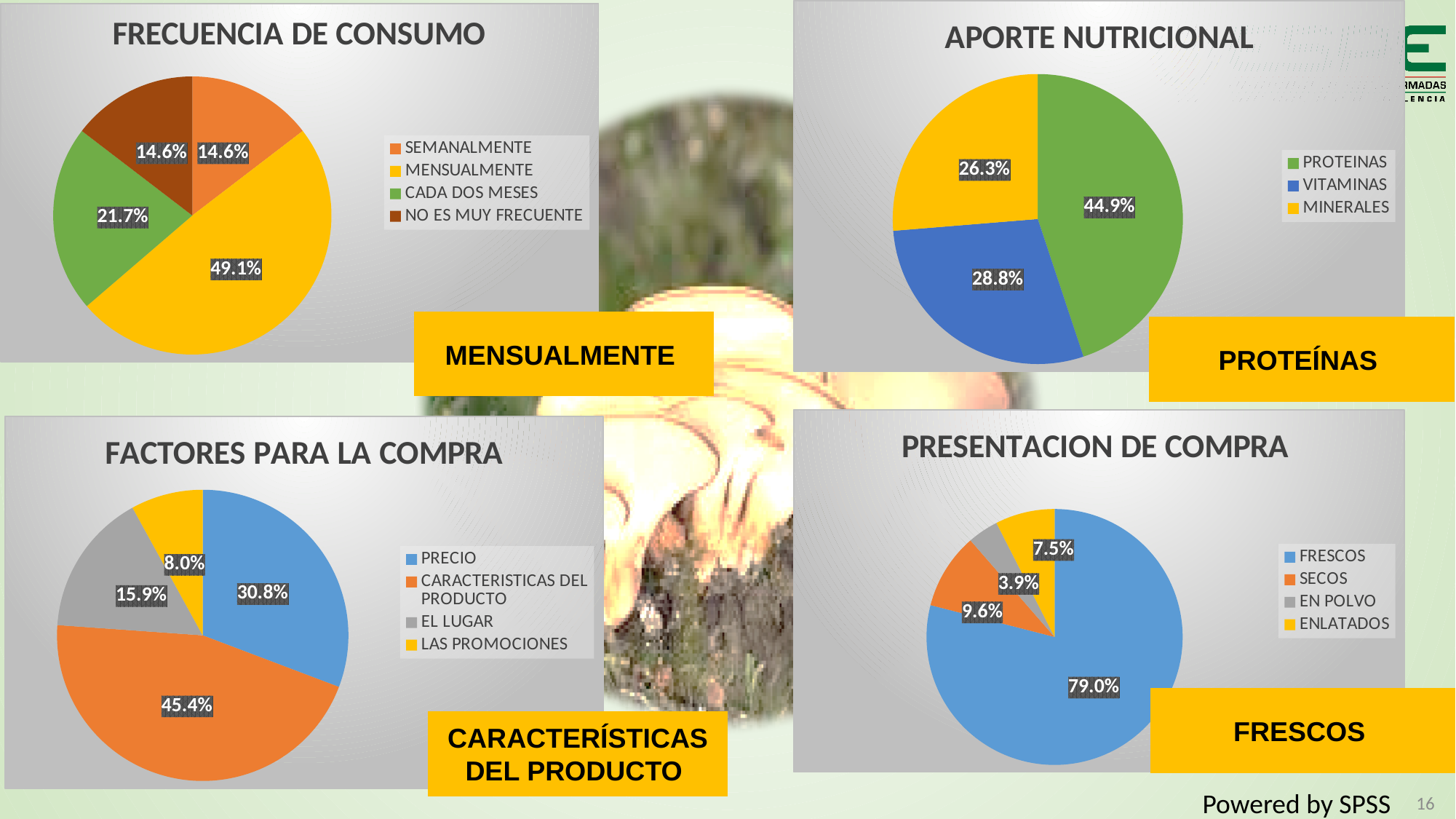
In the FRECUENCIA DE CONSUMO chart, what share is CADA DOS MESES? 21.7% What type of chart is the PRESENTACION DE COMPRA chart? Pie chart In the FACTORES PARA LA COMPRA chart, which factor has the smallest share? LAS PROMOCIONES In the FRECUENCIA DE CONSUMO chart, what share is MENSUALMENTE? 49.1% In the APORTE NUTRICIONAL chart, what is the share for VITAMINAS? 28.8% In the FACTORES PARA LA COMPRA chart, what is the share for PRECIO? 30.8% In the PRESENTACION DE COMPRA chart, what is the share for FRESCOS? 79.0% In the APORTE NUTRICIONAL chart, which category has the largest share? PROTEINAS In the APORTE NUTRICIONAL chart, what is the difference between the PROTEINAS and MINERALES shares? 18.6% In the FRECUENCIA DE CONSUMO chart, how many slices does the pie have? 4 In the PRESENTACION DE COMPRA chart, what is the difference between the SECOS and EN POLVO shares? 5.7% In the FACTORES PARA LA COMPRA chart, which is larger, CARACTERISTICAS DEL PRODUCTO or EL LUGAR? CARACTERISTICAS DEL PRODUCTO